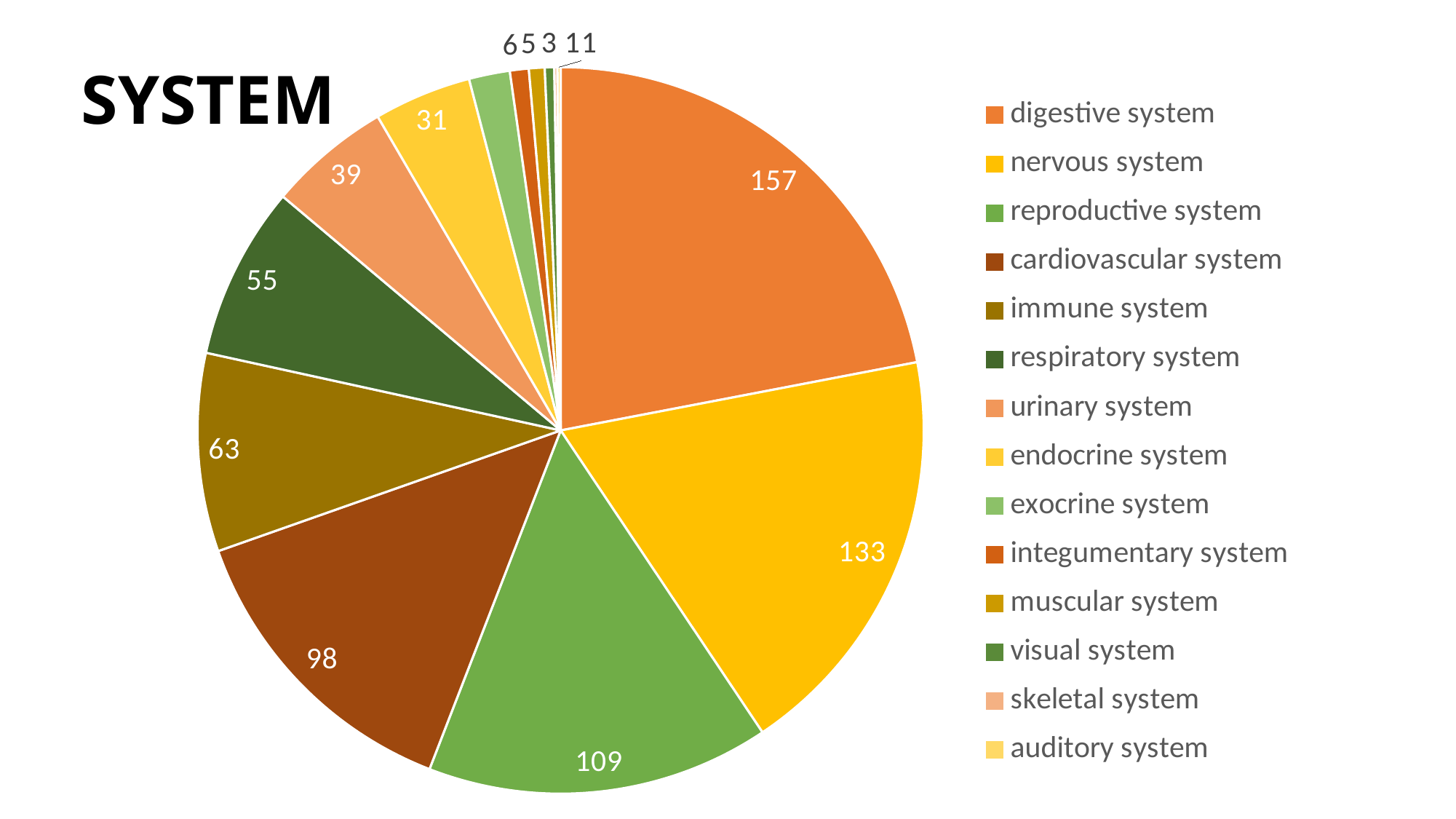
Which system has the largest slice in the pie chart? digestive system What kind of chart is shown on the slide? pie chart What is the title of the chart? SYSTEM What is the value for the urinary system slice? 39 Which is larger, the reproductive system slice or the cardiovascular system slice? reproductive system What is the value for the digestive system slice? 157 What is the value for the nervous system slice? 133 What is the difference between the digestive system and nervous system values? 24 How many categories does the legend list? 14 What is the value for the cardiovascular system slice? 98 What is the value for the endocrine system slice? 31 What is the difference between the immune system and respiratory system values? 8